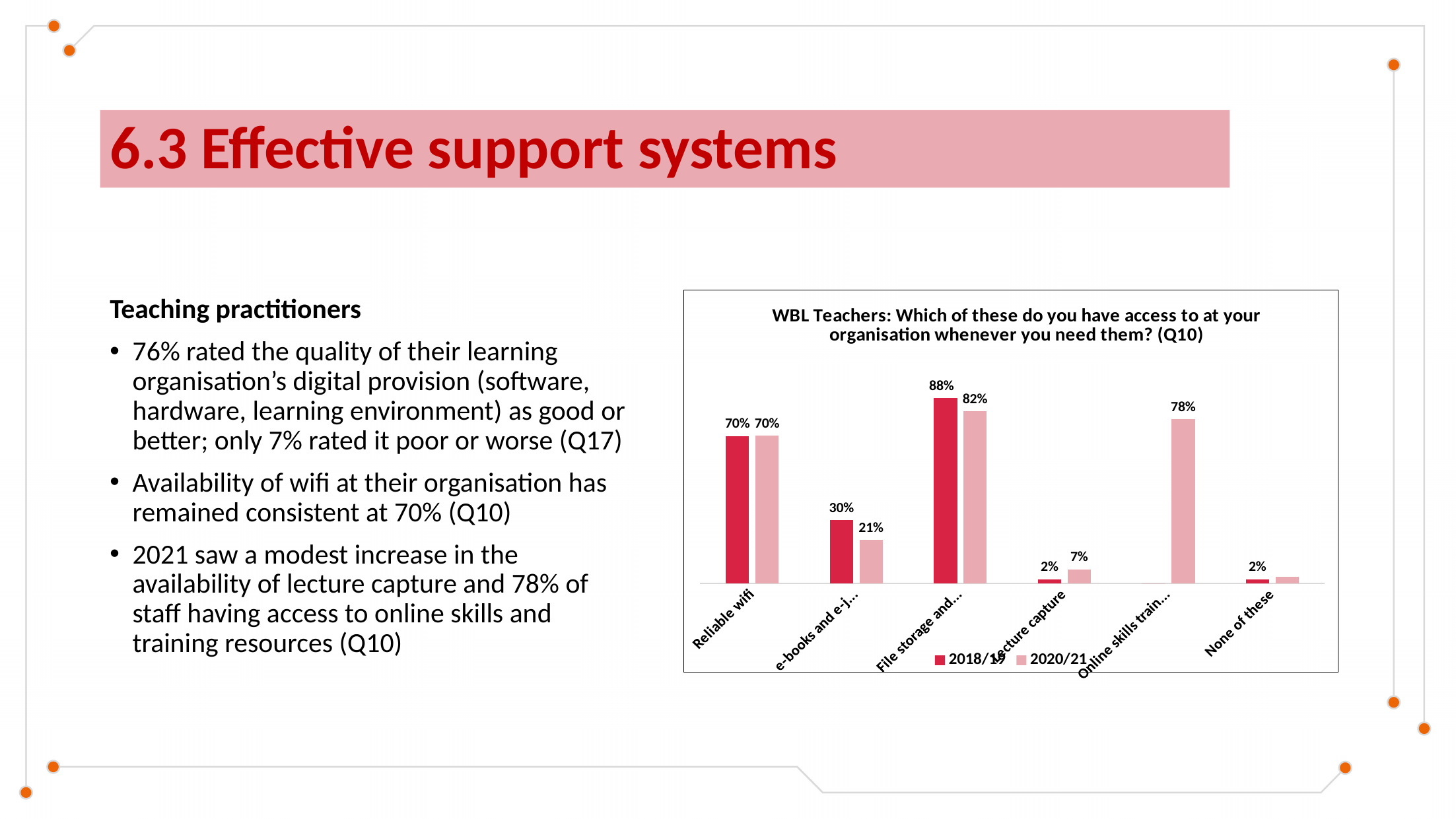
How many categories are shown on the x axis? 6 What is the 2020/21 value for the e-books category? 21% What is the 2020/21 value for the Online skills training category? 78% Which category has the highest 2020/21 value? File storage and… What is the 2018/19 value for Reliable wifi? 70% What kind of chart is shown on the slide? Bar chart For Lecture capture, which series has the larger value, 2018/19 or 2020/21? 2020/21 What is the difference between the 2018/19 and 2020/21 values for the e-books category? 9 percentage points How many series does the legend list? 2 What is the difference between the 2018/19 and 2020/21 values for the File storage category? 6 percentage points Which category has the highest 2018/19 value? File storage and… What is the 2020/21 value for Lecture capture? 7%